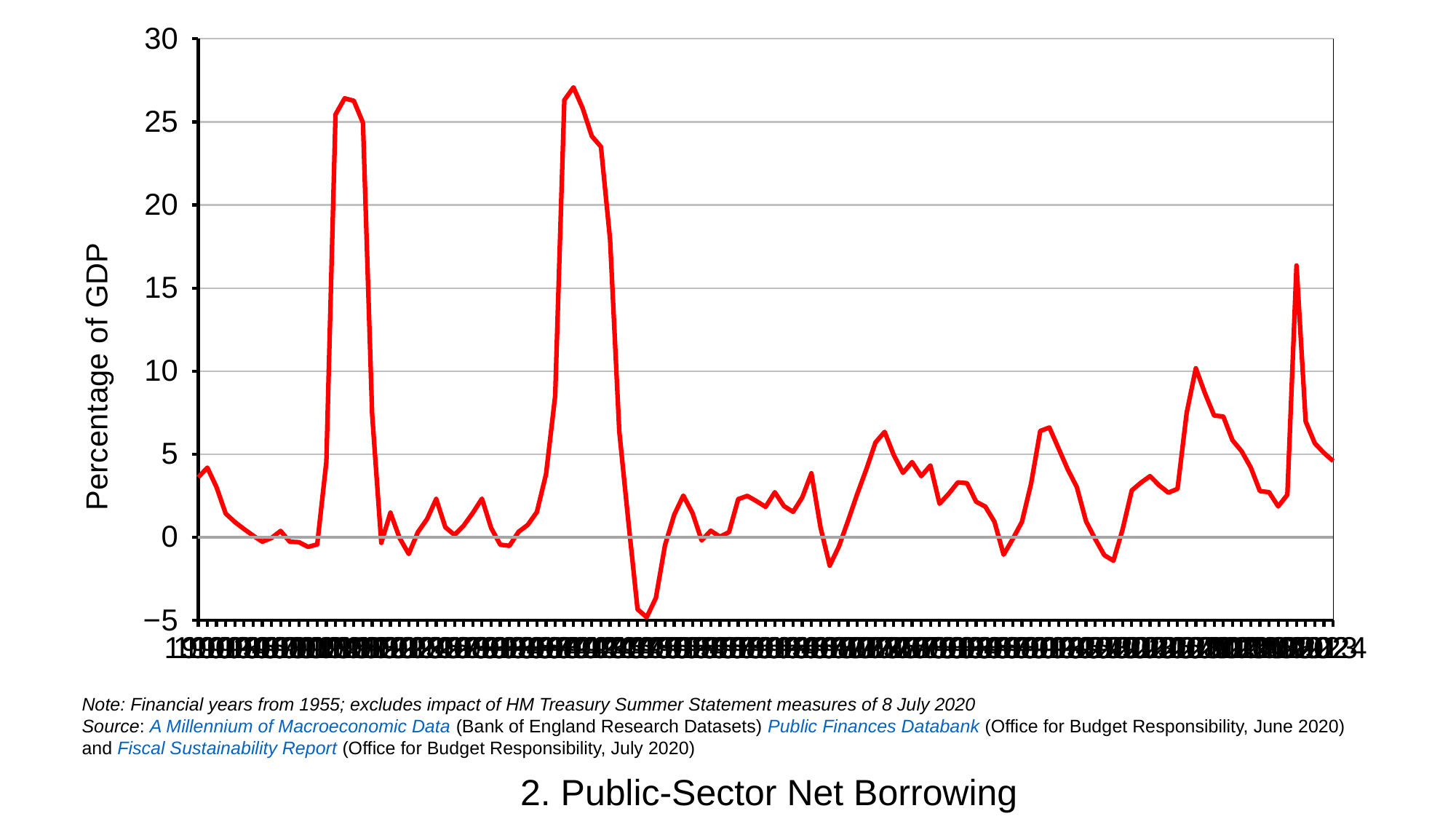
What is the title of the chart? 2. Public-Sector Net Borrowing What kind of chart is shown on the slide? line chart Is the lowest value reached by the line greater or less than -2? less Is the sharp peak near the right-hand end of the chart greater or less than 15? greater What is the label on the vertical axis of the chart? Percentage of GDP Is the lowest value reached by the line greater or less than 0? less How many data series (lines) are plotted on the chart? 1 What is the highest value shown on the vertical axis? 30 How many times does the line rise above 20 on the vertical axis? 2